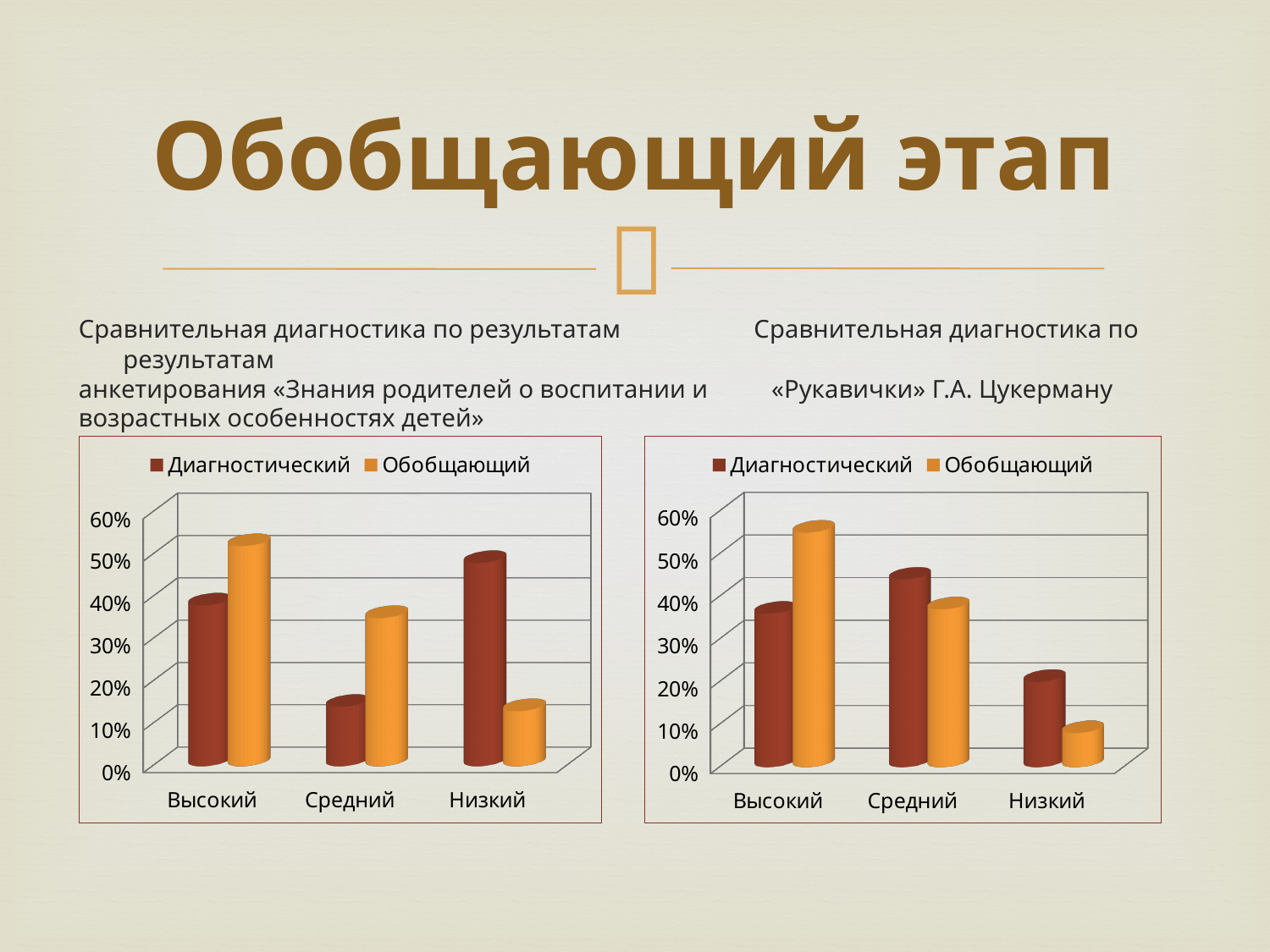
In the left chart, which category has the lowest value for the Диагностический series? Средний In the left chart, is the Обобщающий value for Высокий greater or less than 40%? greater In the left chart, for the Низкий category, which series has the larger value, Диагностический or Обобщающий? Диагностический In the right chart, which category has the lowest value for the Диагностический series? Низкий In the left chart, is the Диагностический value for Средний greater or less than 20%? less In the right chart, for the Высокий category, which series has the larger value, Диагностический or Обобщающий? Обобщающий In the left chart, which category has the highest value for the Обобщающий series? Высокий What type of chart is the left chart on the slide? Bar chart How many series does the legend of the right chart list? 2 In the right chart, is the Обобщающий value for Низкий greater or less than 20%? less How many categories are shown on the x axis of the left chart? 3 In the right chart, which category has the highest value for the Обобщающий series? Высокий